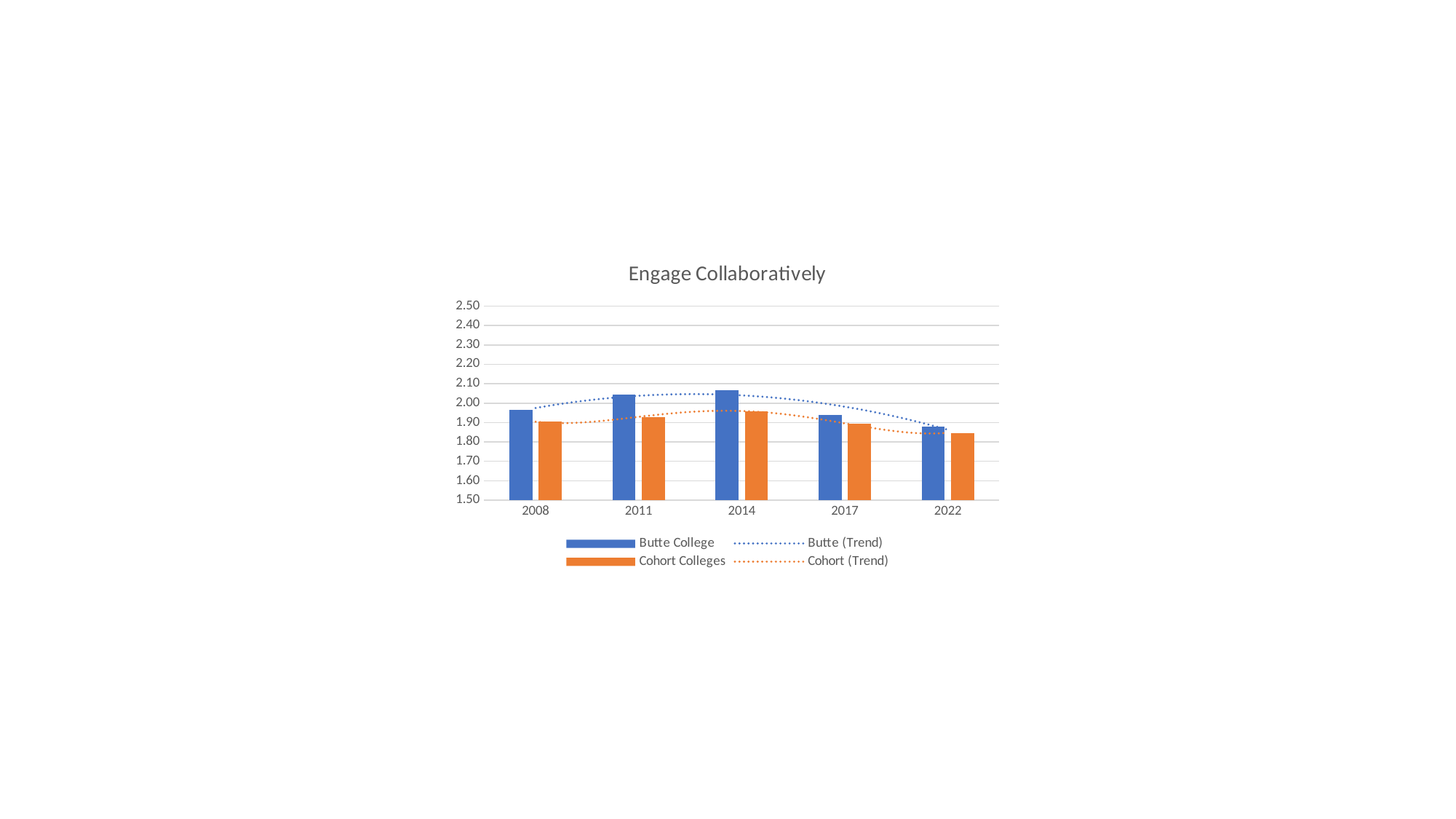
In which year is the Cohort Colleges value lowest? 2022 How many years are shown on the x axis? 5 In 2011, which is larger: the Butte College value or the Cohort Colleges value? Butte College What is the title of the chart? Engage Collaboratively Is the Cohort Colleges value for 2014 greater or less than 2.00? less What kind of chart is shown on the slide? bar chart Is the Butte College value for 2008 greater or less than 2.00? less Is the Cohort Colleges value for 2022 greater or less than 1.90? less In which year is the Butte College value lowest? 2022 How many entries does the legend list? 4 Do the Butte College values rise or fall from 2014 to 2022? fall